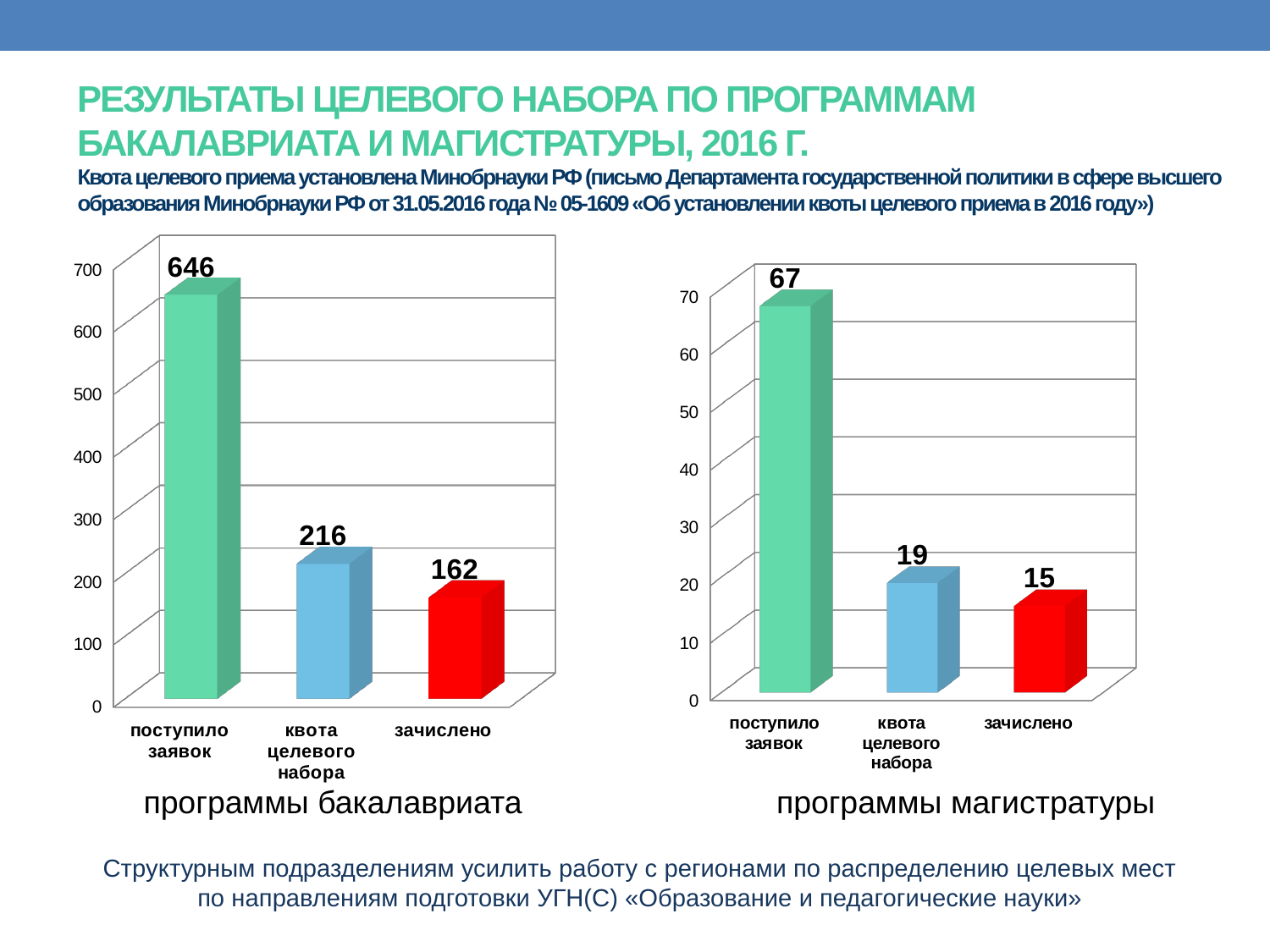
In the left chart (программы бакалавриата), which category has the highest value? поступило заявок In the left chart (программы бакалавриата), what is the value for квота целевого набора? 216 In the right chart (программы магистратуры), which category has the lowest value? зачислено In the left chart (программы бакалавриата), what is the value for поступило заявок? 646 In the right chart (программы магистратуры), what is the value for зачислено? 15 How many categories are shown in the left chart (программы бакалавриата)? 3 In the right chart (программы магистратуры), what is the difference between поступило заявок and квота целевого набора? 48 In the right chart (программы магистратуры), which is larger: квота целевого набора or зачислено? квота целевого набора What kind of chart is the right chart (программы магистратуры)? bar chart In the left chart (программы бакалавриата), what is the difference between квота целевого набора and зачислено? 54 In the left chart (программы бакалавриата), what is the value for зачислено? 162 In the right chart (программы магистратуры), what is the value for поступило заявок? 67